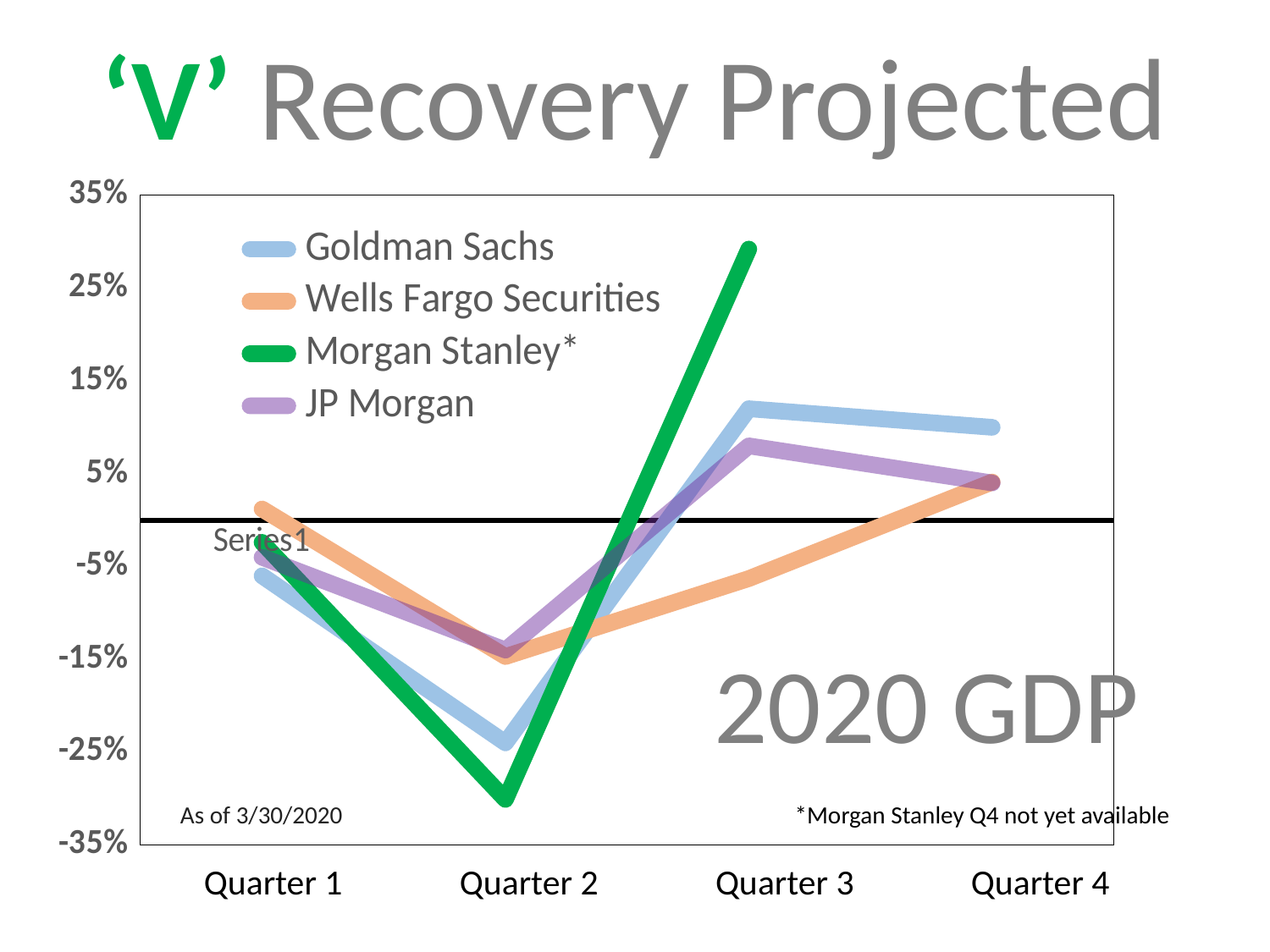
How many quarters are shown on the x axis? 4 Which series has the highest value in Quarter 3? Morgan Stanley* Does the Goldman Sachs line rise or fall from Quarter 1 to Quarter 2? fall In Quarter 2, which is larger: the value for Goldman Sachs or the value for Wells Fargo Securities? Wells Fargo Securities What kind of chart is shown on the slide? line chart Which series has the lowest value in Quarter 3? Wells Fargo Securities Is the Morgan Stanley* value for Quarter 3 greater or less than 25%? greater How many series does the legend list? 4 Is the Goldman Sachs value for Quarter 2 greater or less than -15%? less What is the title of the slide? 'V' Recovery Projected Which series has the lowest value in Quarter 2? Morgan Stanley* Is the Wells Fargo Securities value for Quarter 3 greater or less than 5%? less